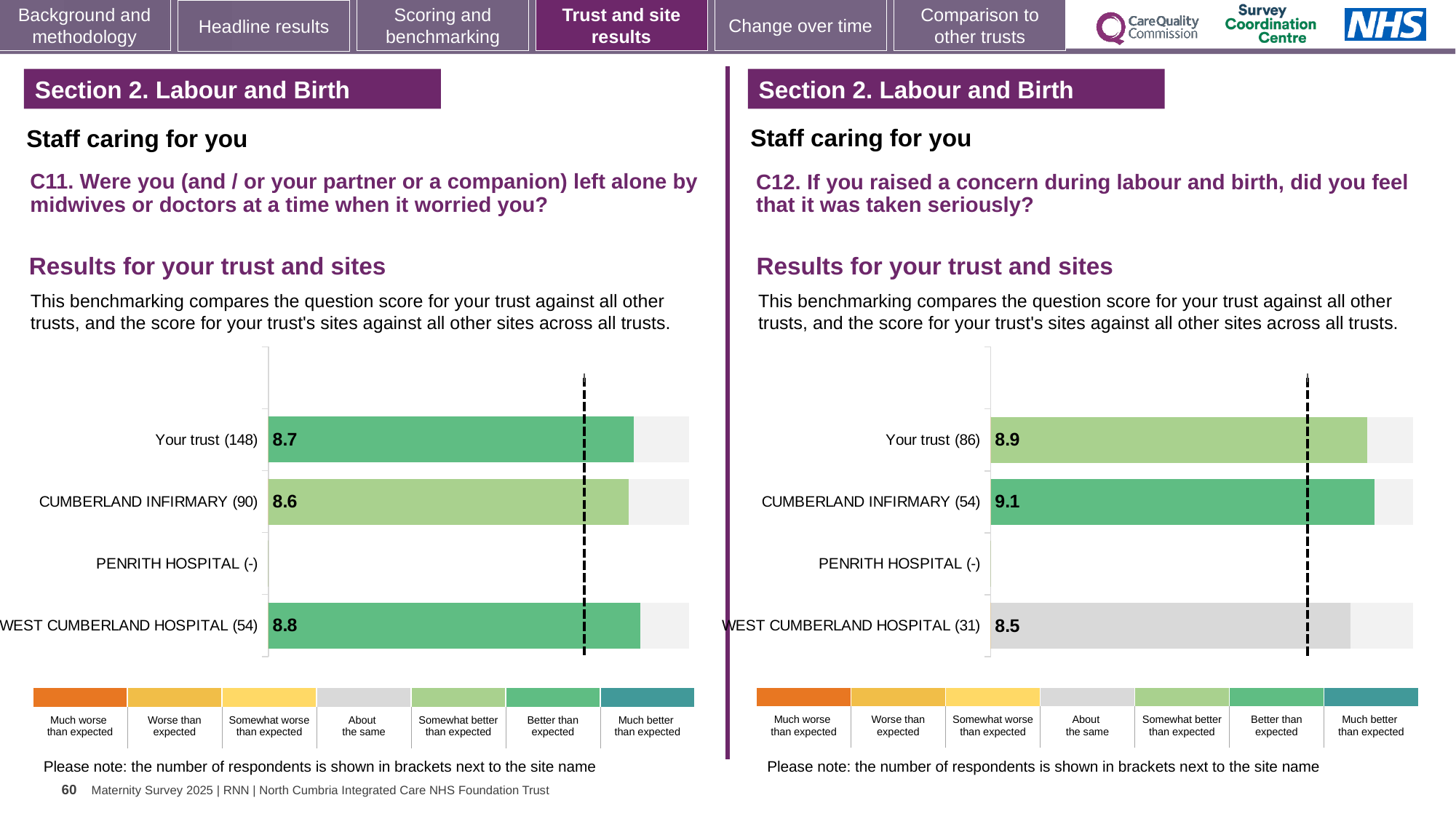
How many rows (trust and sites) are listed in the C11 chart on the left? 4 In the C11 chart on the left, what is the score for Your trust? 8.7 What type of chart is used in the C12 chart on the right? Bar chart In the C12 chart on the right, what is the score for WEST CUMBERLAND HOSPITAL? 8.5 In the C12 chart on the right, which row has the lowest score among those with a value shown? WEST CUMBERLAND HOSPITAL In the C12 chart on the right, what is the score for CUMBERLAND INFIRMARY? 9.1 In the C12 chart on the right, which is larger: the score for Your trust or the score for CUMBERLAND INFIRMARY? CUMBERLAND INFIRMARY In the C11 chart on the left, what is the difference between the scores for WEST CUMBERLAND HOSPITAL and CUMBERLAND INFIRMARY? 0.2 In the C11 chart on the left, what is the score for CUMBERLAND INFIRMARY? 8.6 In the C12 chart on the right, how many respondents are shown in brackets for Your trust? 86 In the C12 chart on the right, what is the difference between the scores for CUMBERLAND INFIRMARY and WEST CUMBERLAND HOSPITAL? 0.6 In the C11 chart on the left, which site or trust row has the highest score? WEST CUMBERLAND HOSPITAL